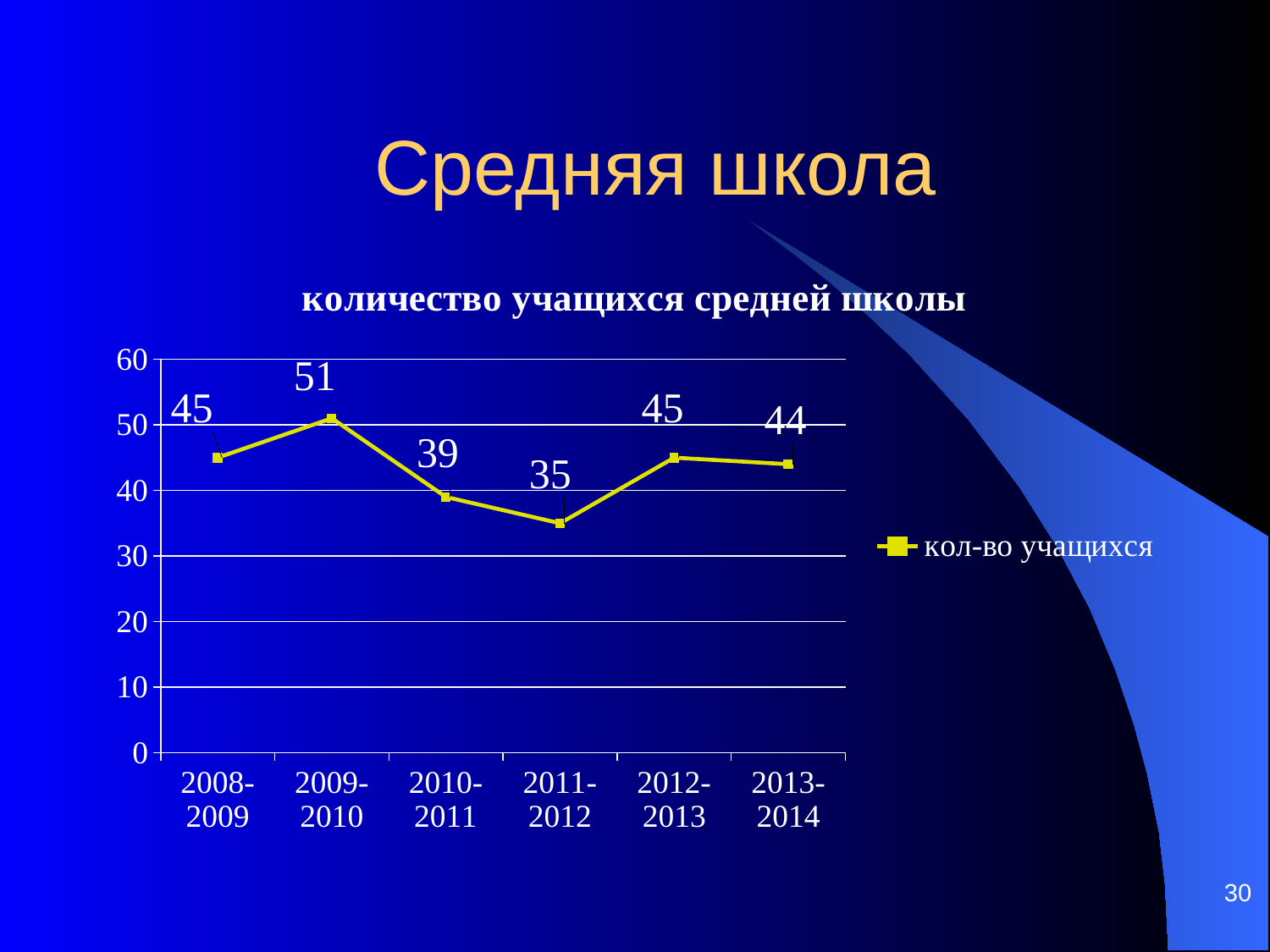
How many series does the legend list? 1 What kind of chart is shown? line chart Is the value for 2009-2010 greater or less than 50? greater Which year has the lowest number of students? 2011-2012 What is the difference between the values for 2009-2010 and 2011-2012? 16 What is the value for 2013-2014? 44 What is the value for 2011-2012? 35 Which is larger, the value for 2010-2011 or the value for 2012-2013? 2012-2013 How many school years are shown on the x axis? 6 Which year has the highest number of students? 2009-2010 What is the value for 2009-2010? 51 What is the title of the chart? количество учащихся средней школы